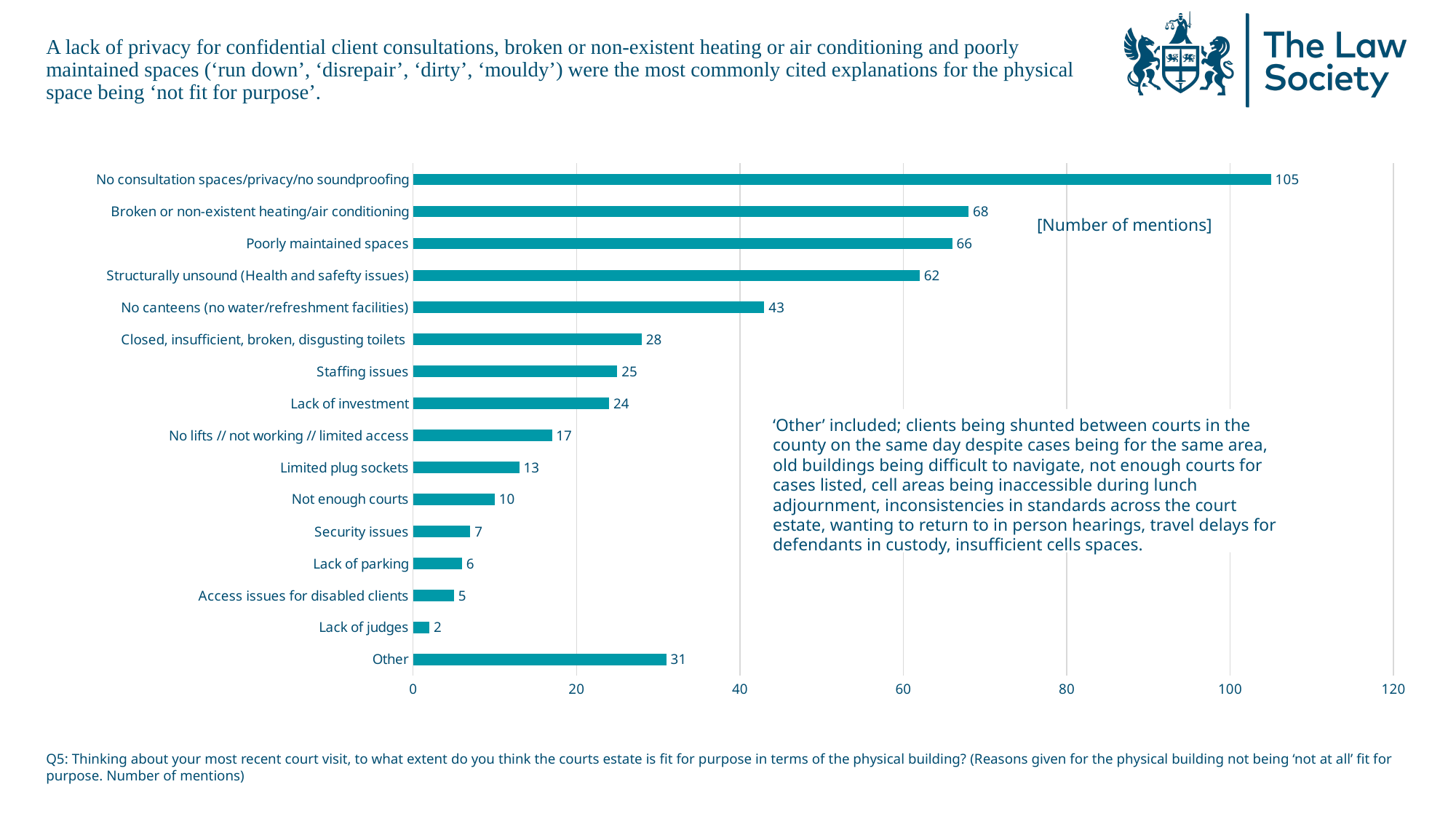
What is the difference in mentions between 'Limited plug sockets' and 'Not enough courts'? 3 How many mentions does 'Lack of judges' have? 2 What does the label in square brackets on the chart say the values represent? Number of mentions How many categories are shown in the chart? 16 Which category has the lowest number of mentions? Lack of judges Which category has the highest number of mentions? No consultation spaces/privacy/no soundproofing Is the value for 'No canteens (no water/refreshment facilities)' greater or less than 40? greater What kind of chart is shown on the slide? Bar chart Which has more mentions: 'Staffing issues' or 'Other'? Other What is the number of mentions for 'Poorly maintained spaces'? 66 How many mentions does 'No consultation spaces/privacy/no soundproofing' have? 105 What is the difference in mentions between 'Broken or non-existent heating/air conditioning' and 'Structurally unsound (Health and safety issues)'? 6